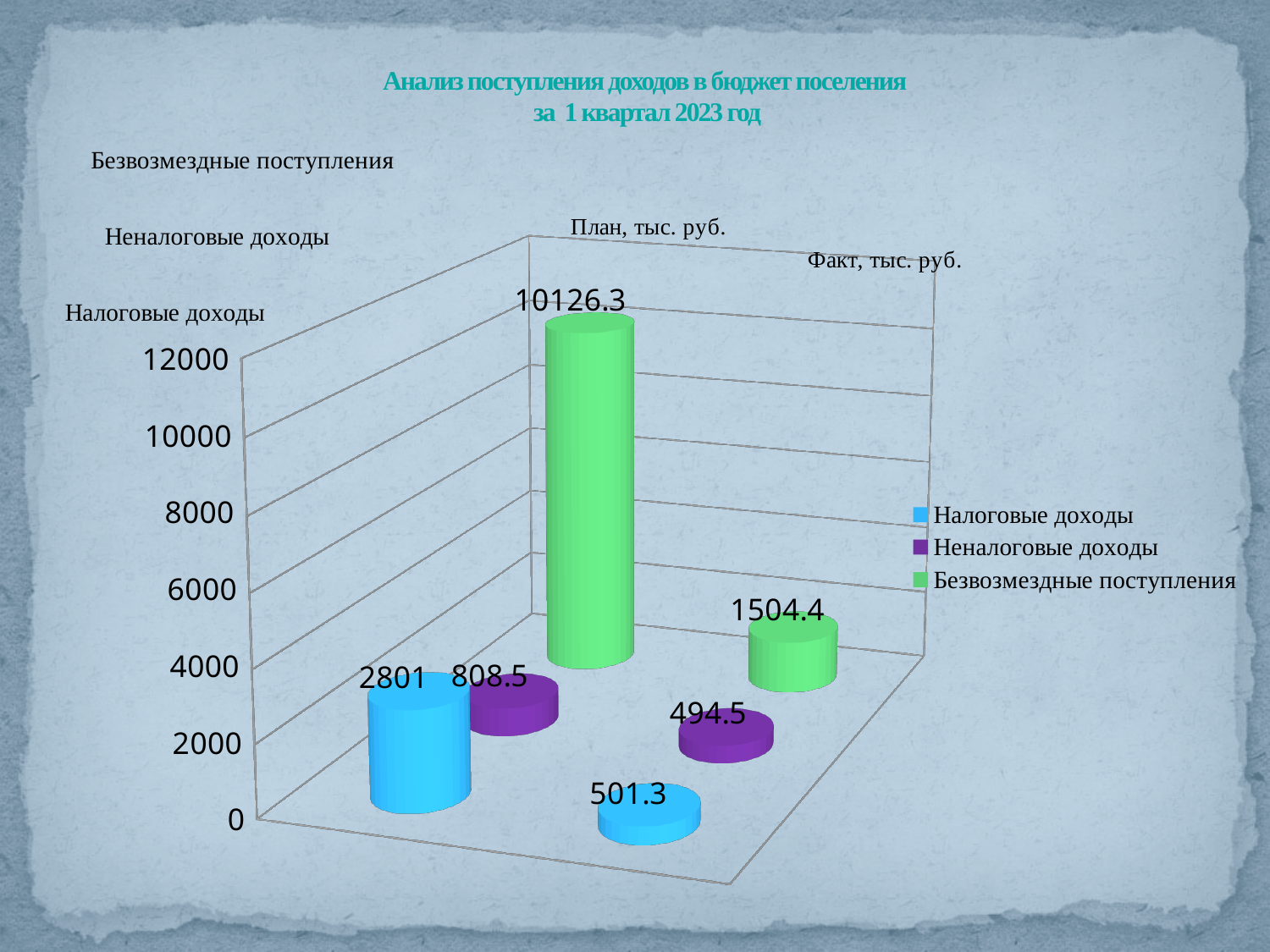
What is the difference between the План and Факт values for Налоговые доходы? 2299.7 What is the title of the chart? Анализ поступления доходов в бюджет поселения за 1 квартал 2023 год Which series has the highest План, тыс. руб. value? Безвозмездные поступления What is the Факт, тыс. руб. value for Налоговые доходы? 501.3 Is the План value for Безвозмездные поступления greater or less than 10000? greater How many series does the legend list? 3 What is the Факт, тыс. руб. value for Безвозмездные поступления? 1504.4 What is the План, тыс. руб. value for Безвозмездные поступления? 10126.3 What kind of chart is shown on the slide? Bar chart Which series has the lowest Факт, тыс. руб. value? Неналоговые доходы Which is larger: the План value for Неналоговые доходы or the Факт value for Неналоговые доходы? План (808.5) What is the План, тыс. руб. value for Неналоговые доходы? 808.5